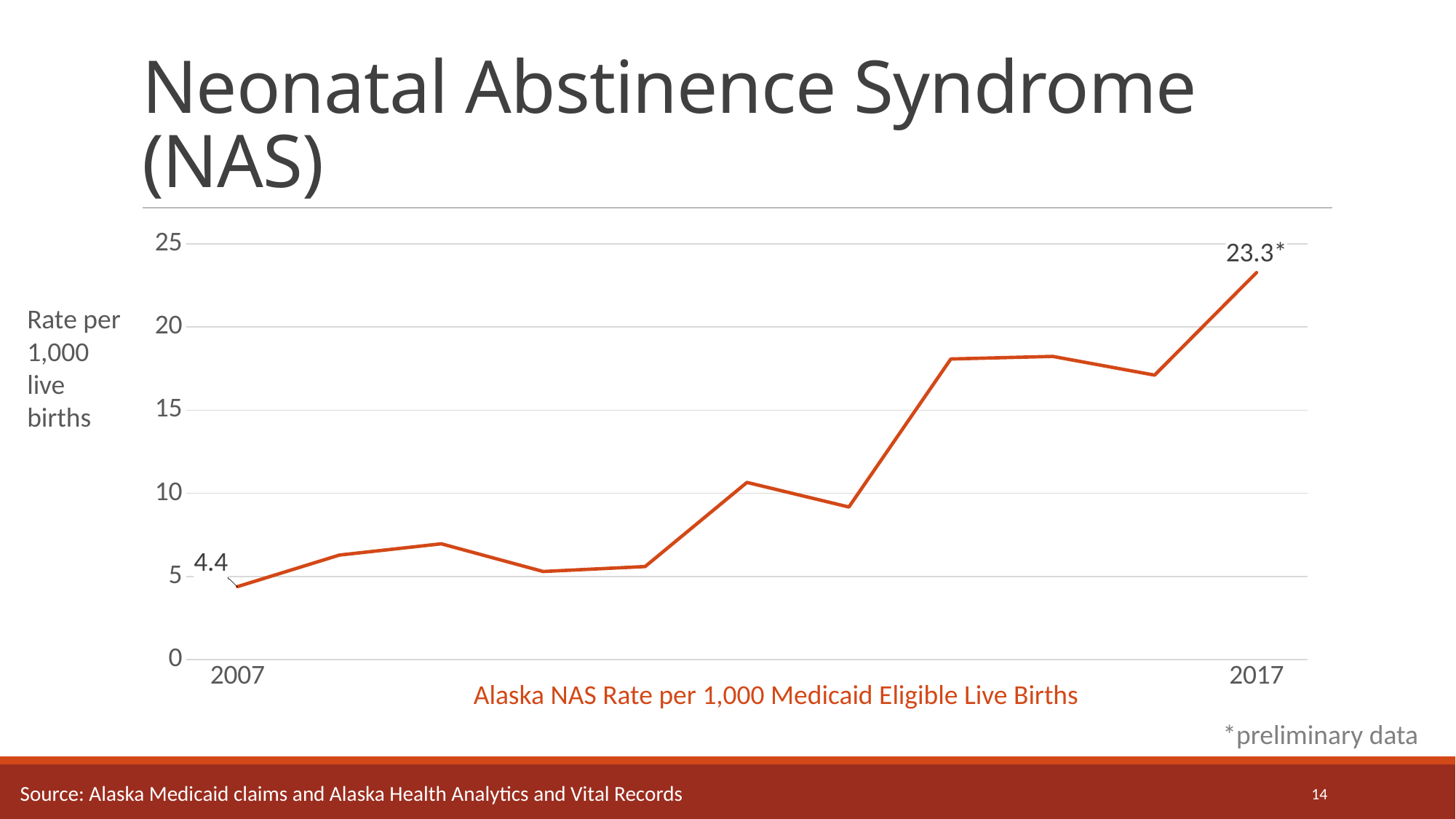
Which year has the highest NAS rate on the chart? 2017 What type of chart is shown on the slide? line chart Which year has the lowest NAS rate on the chart? 2007 Is the NAS rate for 2007 greater or less than 5? less How many data points are plotted on the line? 11 What is the Alaska NAS rate per 1,000 Medicaid eligible live births in 2017? 23.3 Is the NAS rate for 2017 greater or less than 20? greater What is the Alaska NAS rate per 1,000 Medicaid eligible live births in 2007? 4.4 Which year has the larger NAS rate, 2007 or 2017? 2017 By how much did the NAS rate increase from 2007 to 2017? 18.9 Does the NAS rate generally rise or fall from 2007 to 2017? rise What is the title of the chart? Alaska NAS Rate per 1,000 Medicaid Eligible Live Births